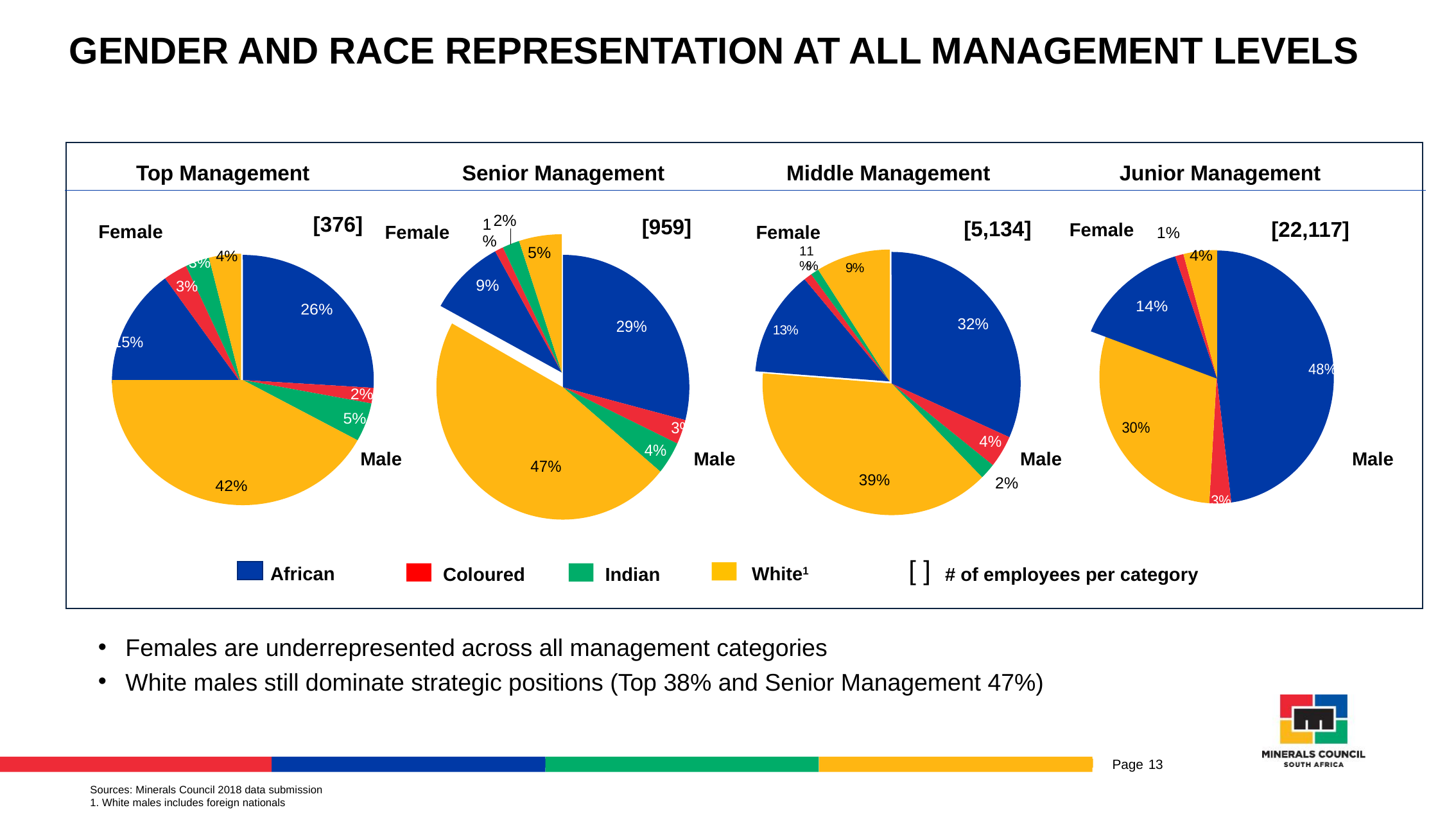
How many employees are in the Middle Management category, as shown in brackets? 5,134 In the Junior Management pie chart, which is larger: the white male share or the African female share? White male share (30%) In the Top Management pie chart, what share is white males? 42% What type of charts are shown on the slide? Pie charts How many pie charts are on the slide? 4 In the Junior Management pie chart, which slice is the largest? African males (48%) How many race categories does the legend list? 4 In the Middle Management pie chart, what share is African males? 32% In the Junior Management pie chart, what share is African males? 48% In the Middle Management pie chart, what share is African females? 13% In the Senior Management pie chart, what is the difference between the white male share and the African male share? 18 percentage points In the Senior Management pie chart, what share is white males? 47%